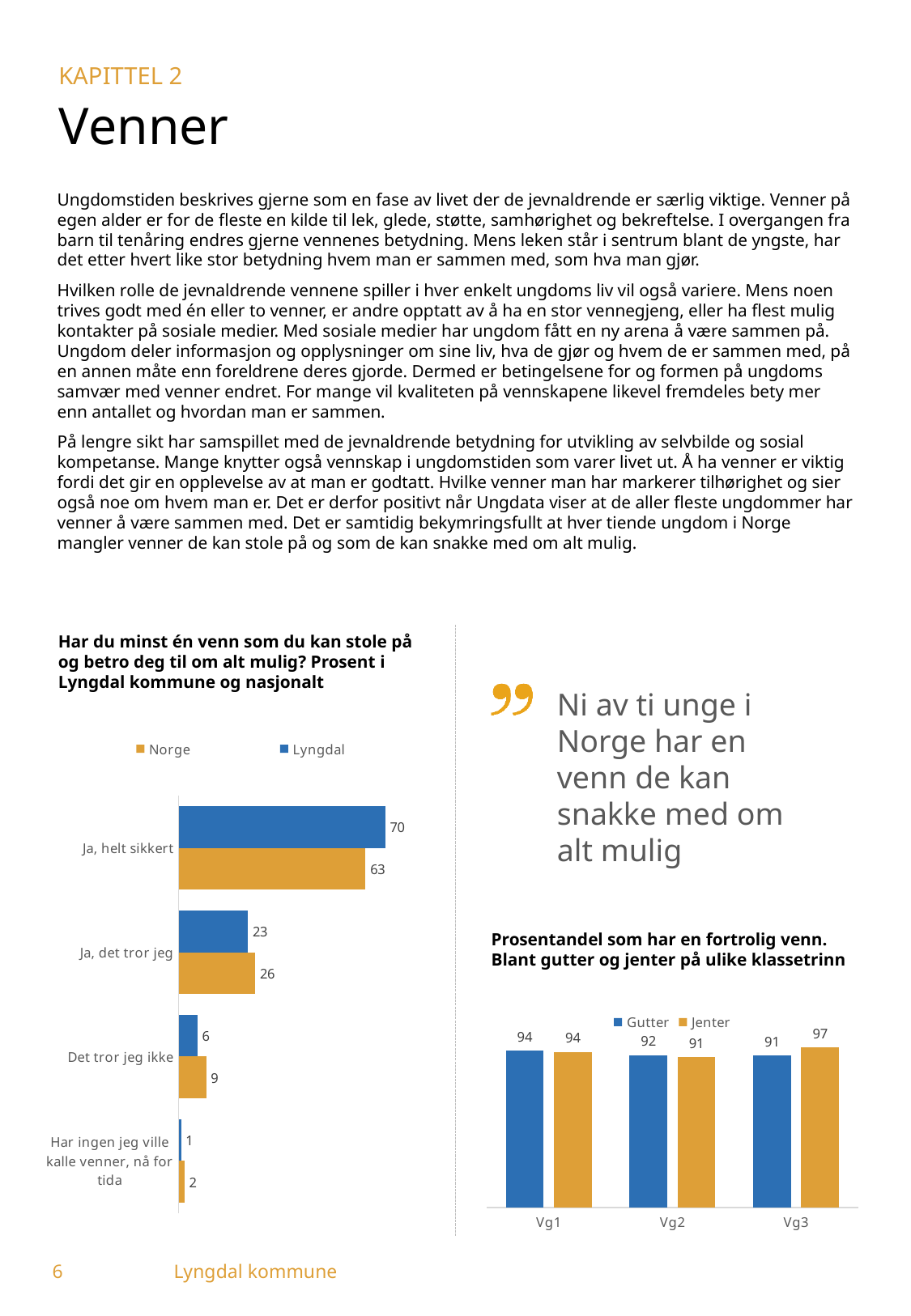
How many series does the legend list in the chart 'Har du minst én venn som du kan stole på...'? 2 In the chart 'Prosentandel som har en fortrolig venn', which colour represents Gutter? blue In the chart 'Har du minst én venn som du kan stole på...', what is the difference between the Lyngdal and Norge values for 'Ja, helt sikkert'? 7 What kind of chart is 'Prosentandel som har en fortrolig venn'? bar chart In the chart 'Har du minst én venn som du kan stole på...', is the Norge value for 'Det tror jeg ikke' larger or smaller than the Lyngdal value? larger In the chart 'Har du minst én venn som du kan stole på...', what is the value for Norge in the category 'Ja, det tror jeg'? 26 In the chart 'Prosentandel som har en fortrolig venn', what is the value for Jenter at Vg3? 97 In the chart 'Har du minst én venn som du kan stole på...', which category has the lowest value for Lyngdal? Har ingen jeg ville kalle venner, nå for tida In the chart 'Prosentandel som har en fortrolig venn', what is the difference between Jenter and Gutter at Vg3? 6 In the chart 'Prosentandel som har en fortrolig venn', which class level has the highest value for Jenter? Vg3 In the chart 'Har du minst én venn som du kan stole på...', what is the value for Lyngdal in the category 'Ja, helt sikkert'? 70 How many categories are shown in the chart 'Har du minst én venn som du kan stole på...'? 4